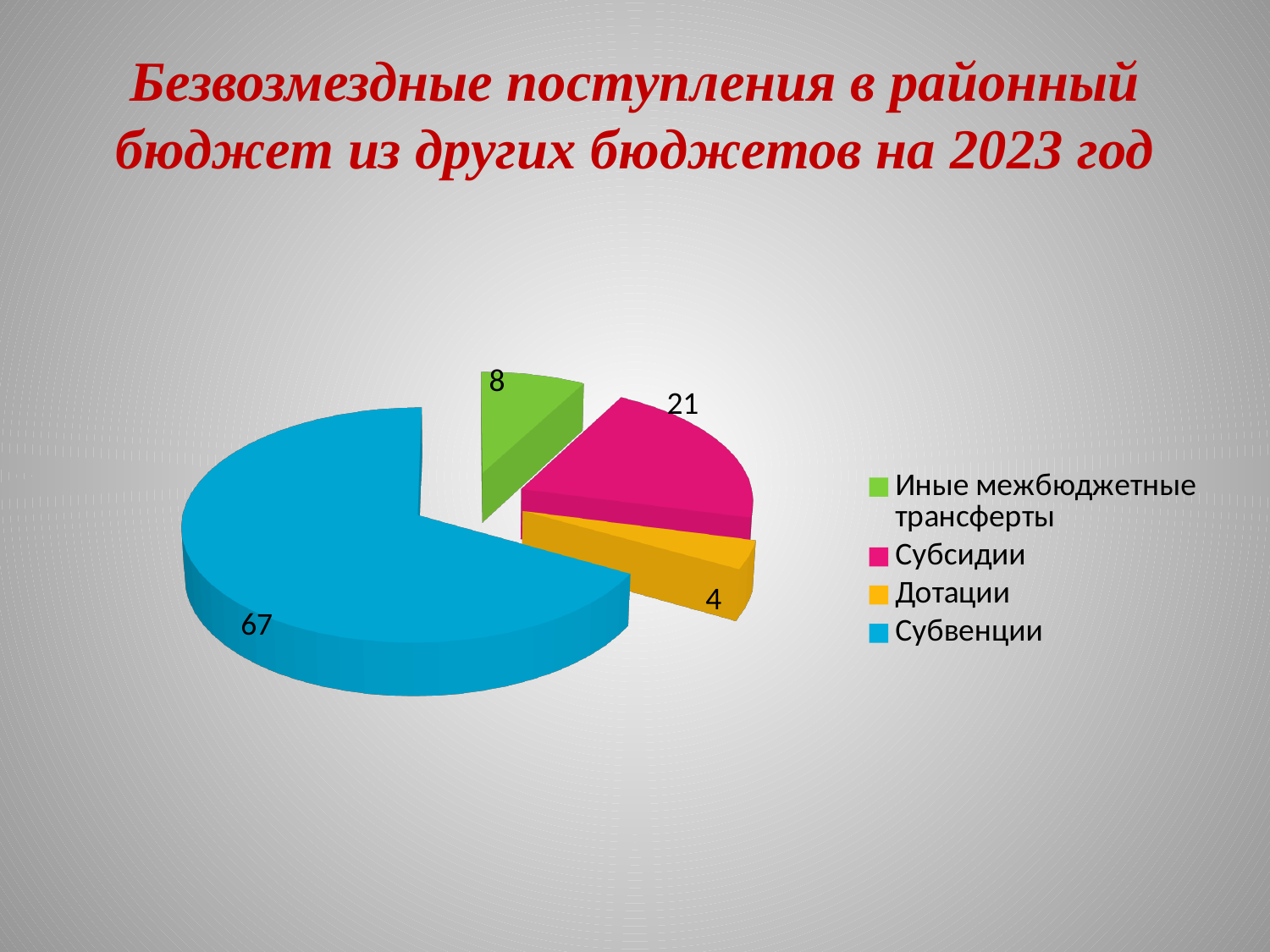
What is the value for Дотации? 4 Which category has the largest slice? Субвенции What share of the pie does Субвенции represent? 67% Which is larger, the value for Субсидии or the value for Иные межбюджетные трансферты? Субсидии What colour is the slice for Дотации? Yellow Which category has the smallest slice? Дотации What is the value for Иные межбюджетные трансферты? 8 What is the value for Субвенции? 67 What is the difference between the values for Субвенции and Субсидии? 46 What type of chart is shown on the slide? Pie chart What is the value for Субсидии? 21 How many categories does the pie chart have? 4